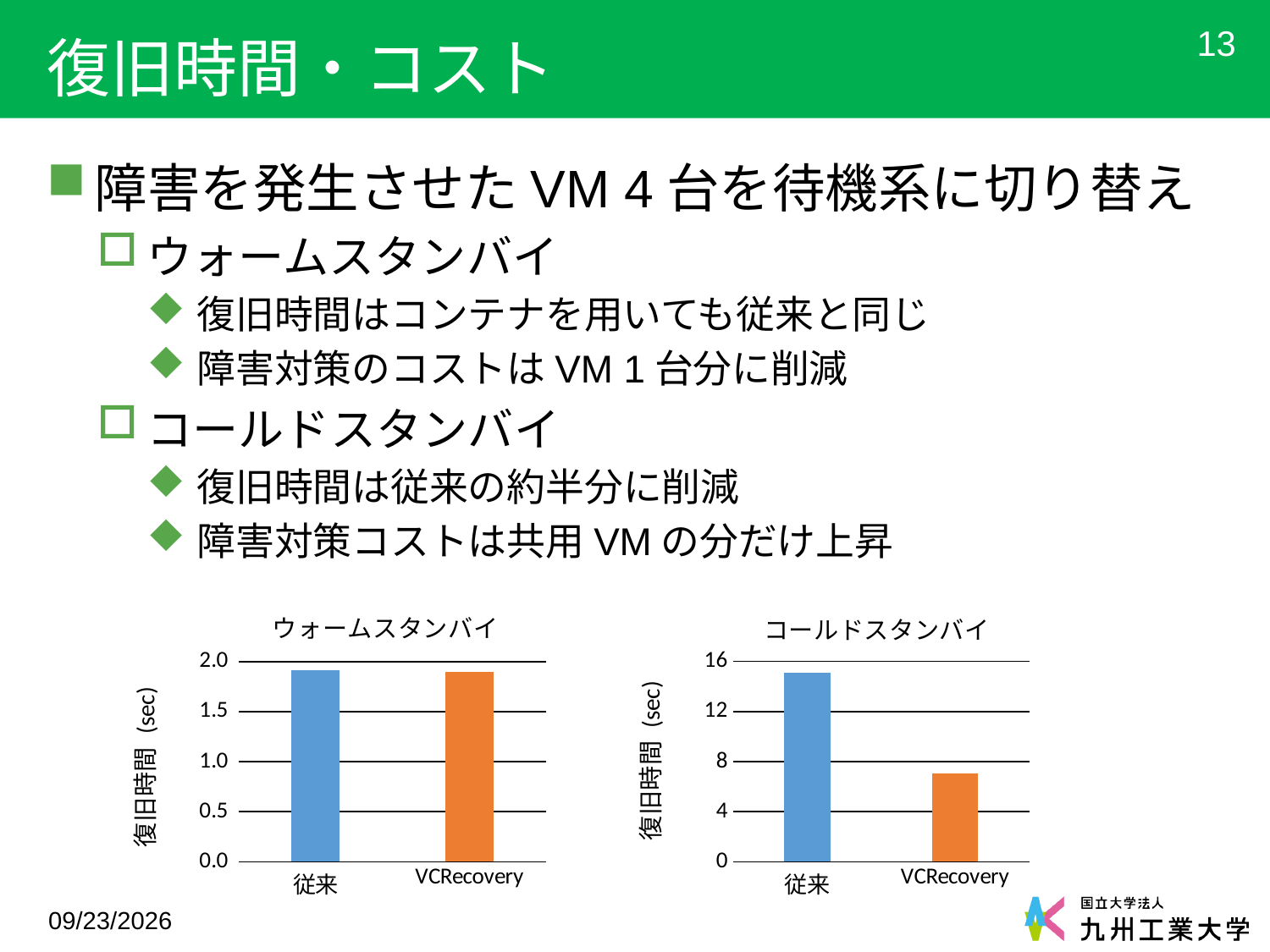
In the コールドスタンバイ chart, is the value for 従来 greater or less than 12? greater What kind of chart is the コールドスタンバイ chart? bar chart In the ウォームスタンバイ chart, is the value for VCRecovery greater or less than 2.0? less What is the y-axis label of the ウォームスタンバイ chart? 復旧時間 (sec) In the コールドスタンバイ chart, is the value for VCRecovery greater or less than 8? less In the コールドスタンバイ chart, which category has the lowest recovery time? VCRecovery How many categories are shown in the ウォームスタンバイ chart? 2 In the コールドスタンバイ chart, which category has the highest recovery time? 従来 In the コールドスタンバイ chart, which is larger, the value for 従来 or the value for VCRecovery? 従来